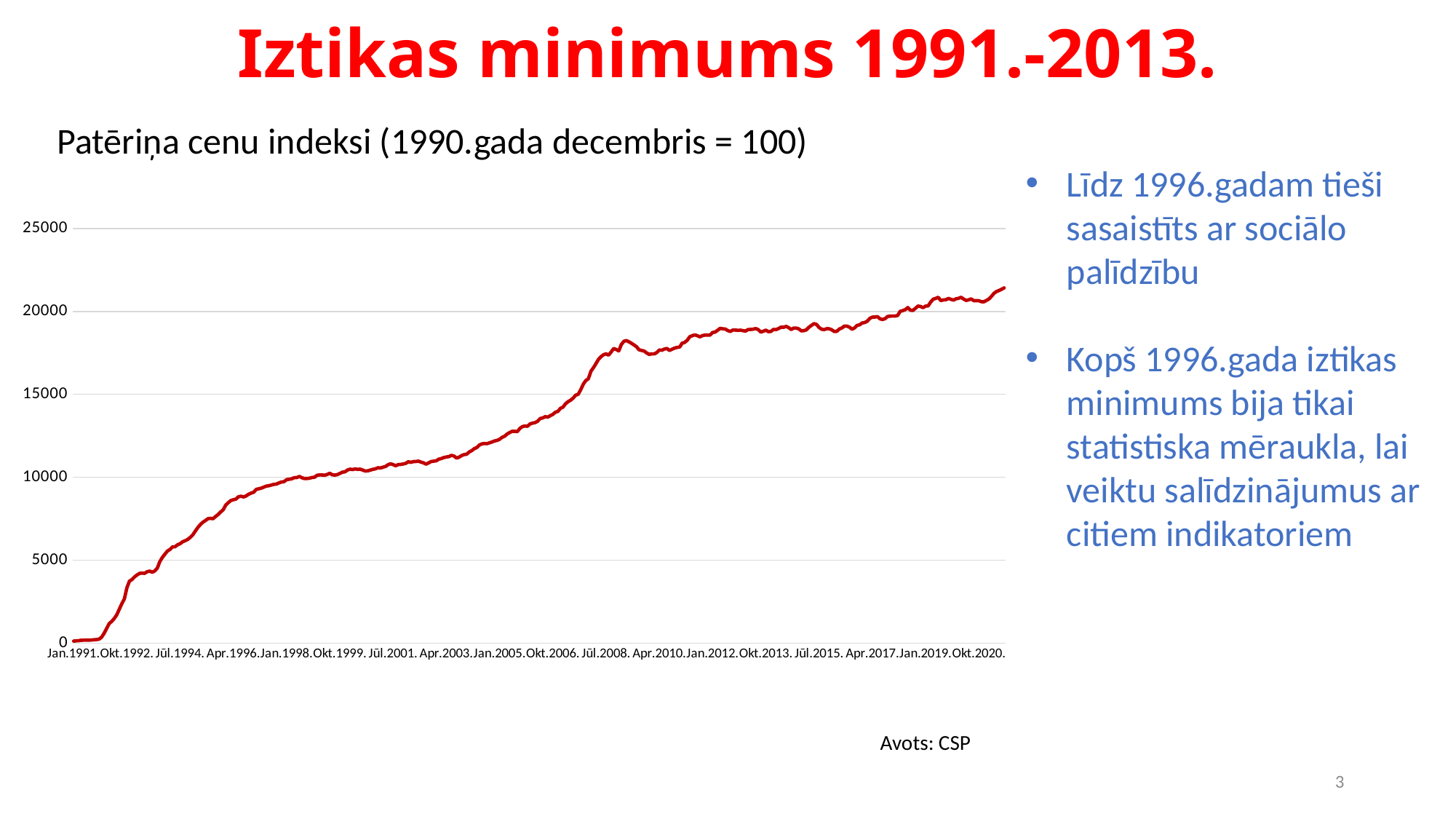
Is the value for Okt.2020 greater or less than 20000? greater Is the value for Apr.1996 greater or less than 10000? less At which x-axis label is the plotted value lowest? Jan.1991 Which is larger, the value for Jan.1998 or the value for Jan.2012? Jan.2012 Do the values generally rise or fall along the x axis from Jan.1991 to Okt.2020? rise How many lines (series) are plotted in the chart? 1 Is the value for Jūl.2008 greater or less than 15000? greater What colour is the line plotted in the chart? red What is the title of the chart? Patēriņa cenu indeksi (1990.gada decembris = 100) At which x-axis label is the plotted value highest? Okt.2020 What kind of chart is shown on the slide? line chart